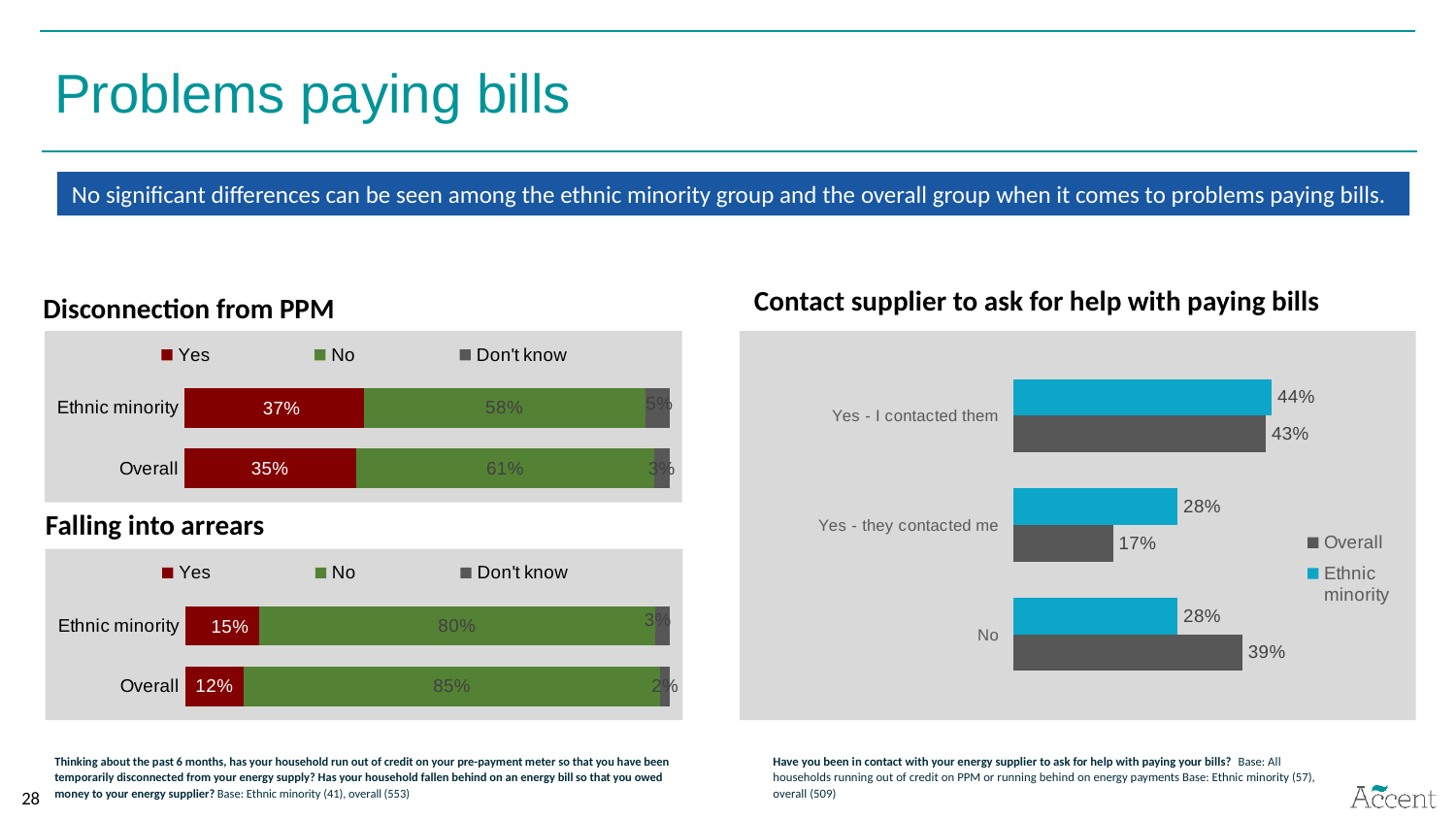
In the 'Contact supplier to ask for help with paying bills' chart, what is the Ethnic minority value for 'Yes - they contacted me'? 28% In the 'Falling into arrears' chart, what percentage of the Ethnic minority group answered No? 80% What type of chart is the 'Contact supplier to ask for help with paying bills' chart? Bar chart In the 'Disconnection from PPM' chart, what percentage of the Overall group answered No? 61% In the 'Contact supplier to ask for help with paying bills' chart, what is the difference between the Overall and Ethnic minority values for 'No'? 11% In the 'Contact supplier to ask for help with paying bills' chart, which group has the higher value for 'Yes - they contacted me'? Ethnic minority In the 'Contact supplier to ask for help with paying bills' chart, which response category has the highest Overall value? Yes - I contacted them How many series does the legend of the 'Disconnection from PPM' chart list? 3 In the 'Falling into arrears' chart, what percentage of the Overall group answered Yes? 12% In the 'Contact supplier to ask for help with paying bills' chart, what is the Overall value for 'No'? 39% In the 'Falling into arrears' chart, what is the difference between the Overall and Ethnic minority 'No' percentages? 5% In the 'Disconnection from PPM' chart, what percentage of the Ethnic minority group answered Yes? 37%